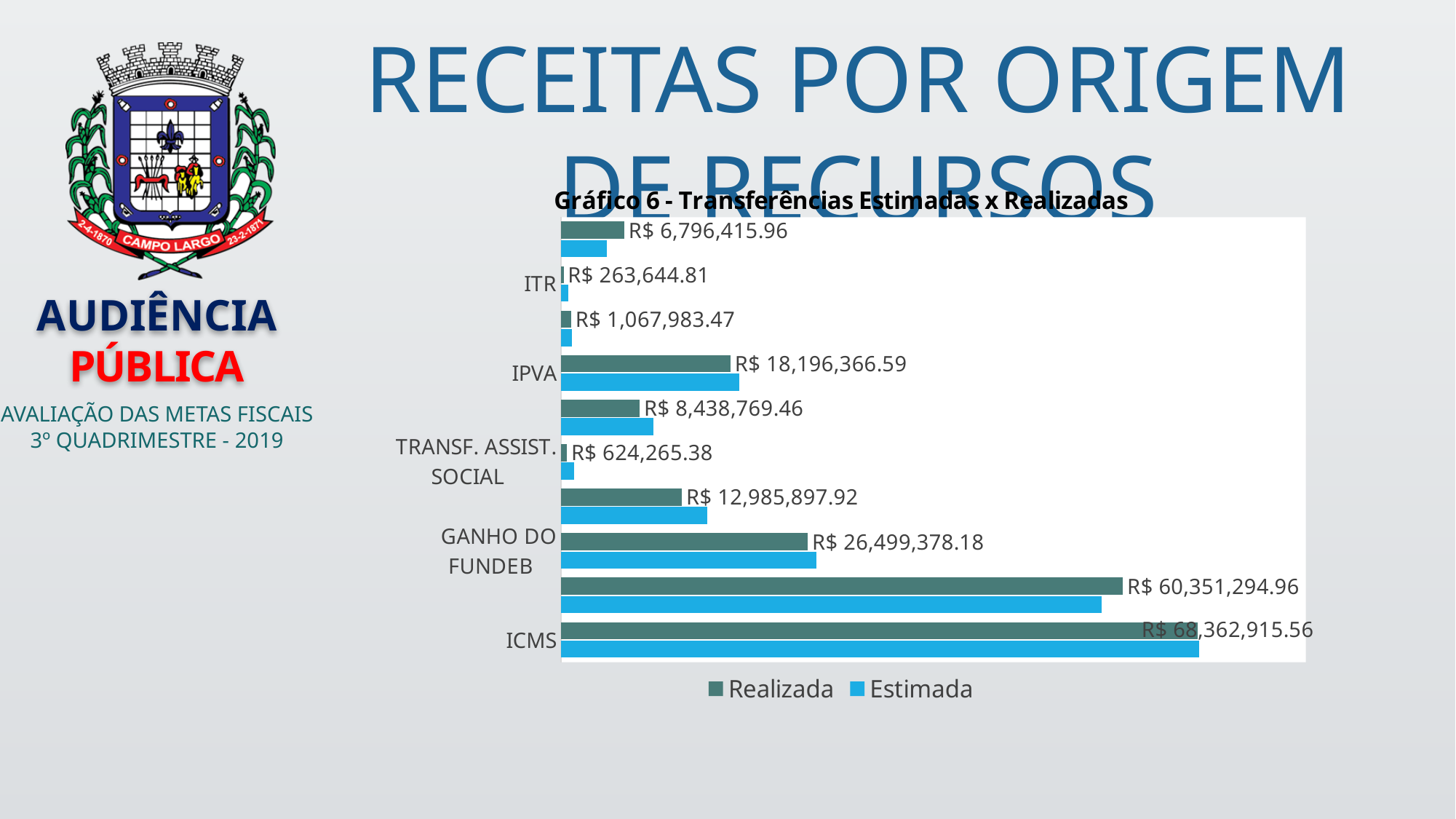
What is the Realizada value for IPVA? R$ 18,196,366.59 What is the Realizada value for TRANSF. ASSIST. SOCIAL? R$ 624,265.38 What is the difference between the Realizada values for ICMS and GANHO DO FUNDEB? R$ 41,863,537.38 Which category has the highest Realizada value? ICMS What is the Realizada value for ICMS? R$ 68,362,915.56 What is the Realizada value for GANHO DO FUNDEB? R$ 26,499,378.18 Which category has the lowest Realizada value? ITR Which has the larger Realizada value, IPVA or GANHO DO FUNDEB? GANHO DO FUNDEB How many series does the legend list? 2 What is the Realizada value for ITR? R$ 263,644.81 What kind of chart is shown on the slide? Bar chart